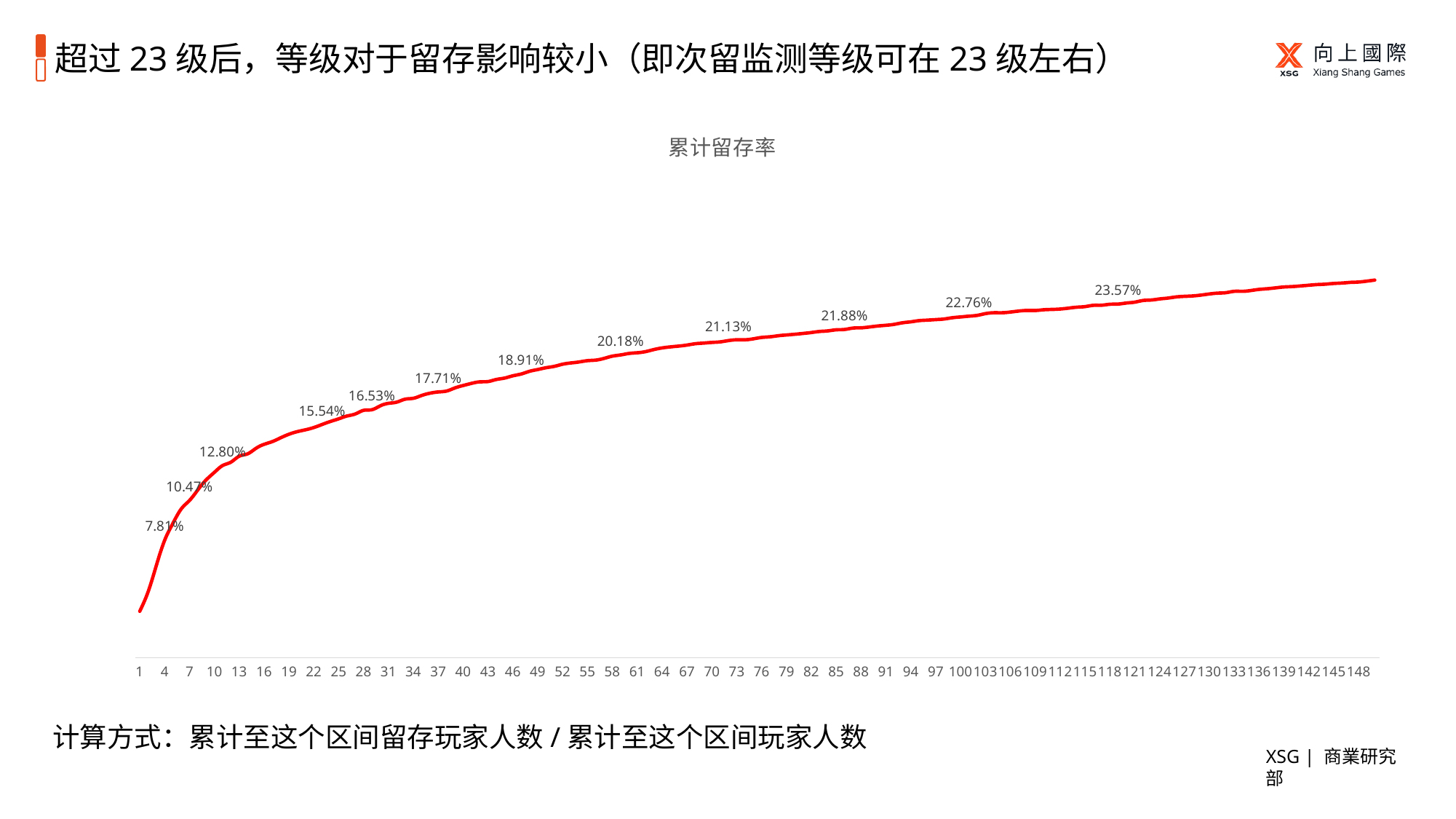
What is the difference between the highest labelled value (23.57%) and the lowest labelled value (7.81%)? 15.76% What is the highest value printed as a data label on the chart? 23.57% What colour is the plotted line? red What kind of chart is shown on the slide? line chart How many data labels are printed on the line? 12 What is the lowest value printed as a data label on the chart? 7.81% Which labelled value is larger: 20.18% or 18.91%? 20.18% What is the title of the chart? 累计留存率 Do the values rise or fall as the level increases along the x axis? rise What is the difference between the last two labelled values, 23.57% and 22.76%? 0.81% What is the difference between the second labelled value (10.47%) and the first labelled value (7.81%)? 2.66% How many lines are plotted on the chart? 1